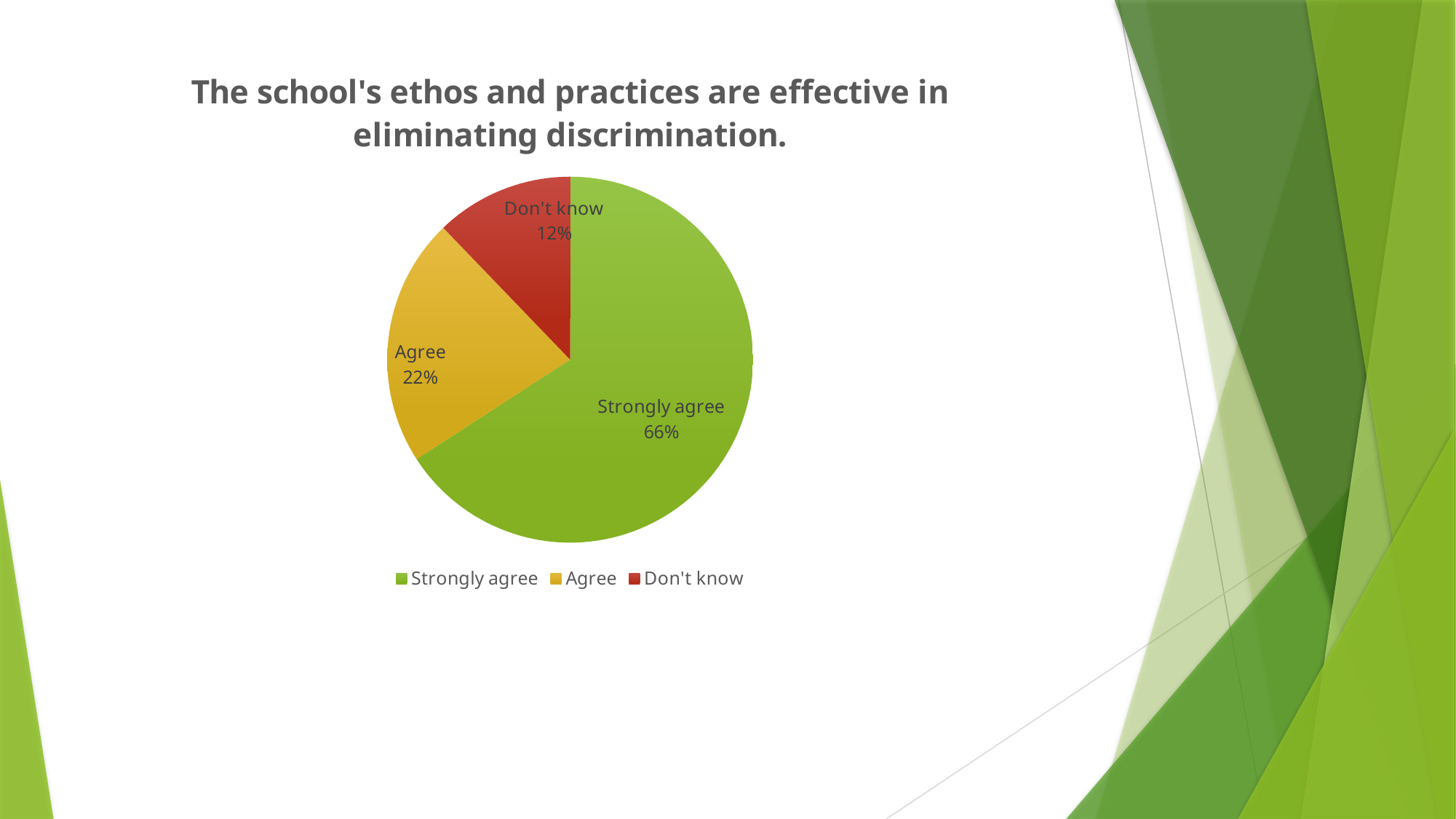
Which response has the smallest share of the pie? Don't know How many slices does the pie chart have? 3 What percentage of respondents chose 'Strongly agree'? 66% Which response has the largest share of the pie? Strongly agree What is the difference in percentage points between 'Strongly agree' and 'Agree'? 44 What percentage of respondents chose 'Don't know'? 12% What kind of chart is shown on the slide? pie chart What is the difference in percentage points between 'Agree' and 'Don't know'? 10 What percentage of respondents chose 'Agree'? 22% Which is larger, the share for 'Agree' or the share for 'Don't know'? Agree What colour is the 'Don't know' slice? red What is the title of the chart? The school's ethos and practices are effective in eliminating discrimination.